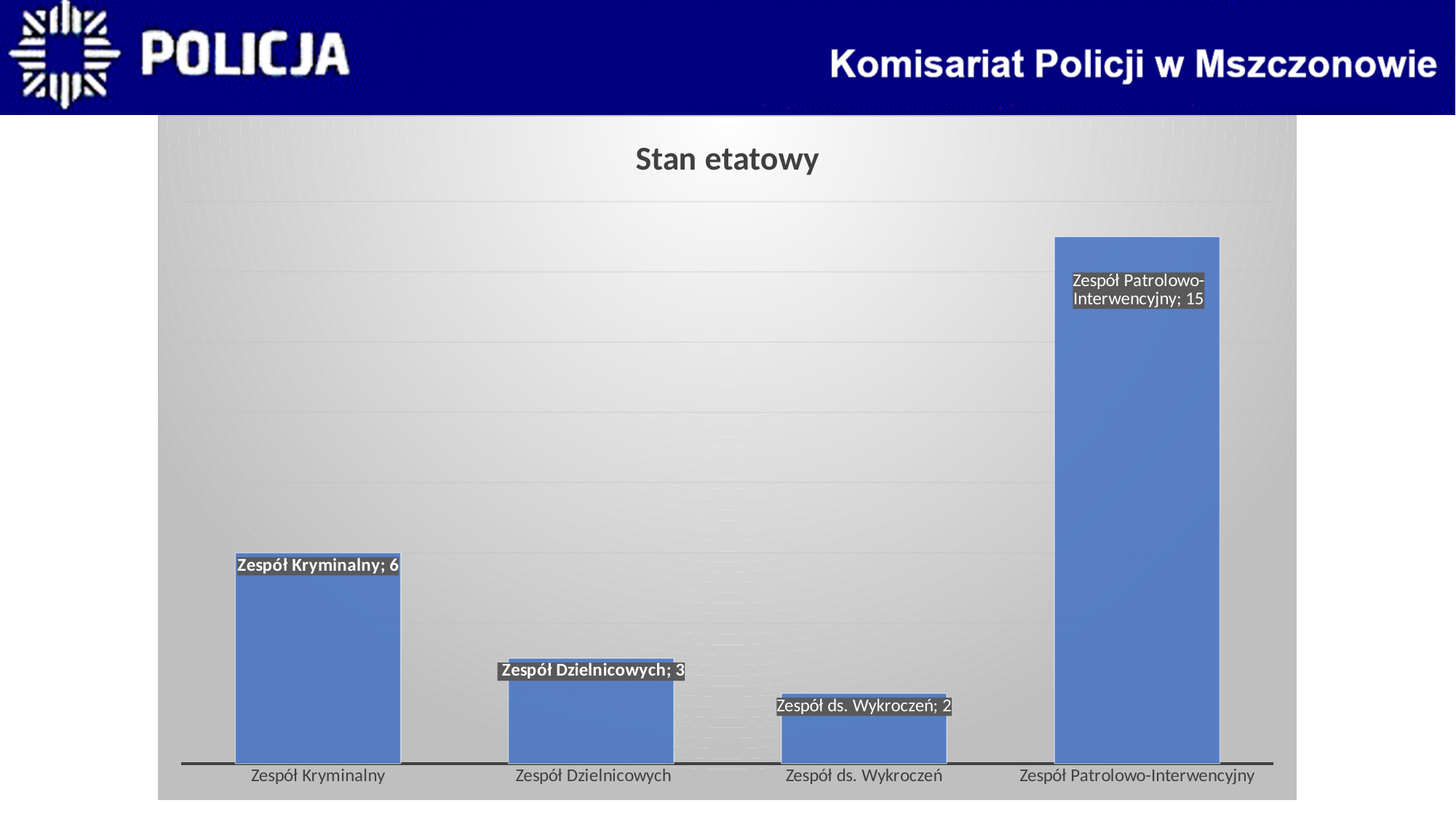
What is the difference between the values for Zespół Kryminalny and Zespół Dzielnicowych? 3 How many categories are shown in the chart? 4 What is the value for Zespół Kryminalny? 6 What is the difference between the values for Zespół Patrolowo-Interwencyjny and Zespół Kryminalny? 9 What is the title of the chart? Stan etatowy What kind of chart is shown on the slide? bar chart Which is larger, the value for Zespół Dzielnicowych or the value for Zespół ds. Wykroczeń? Zespół Dzielnicowych What is the value for Zespół Dzielnicowych? 3 What is the value for Zespół Patrolowo-Interwencyjny? 15 What is the value for Zespół ds. Wykroczeń? 2 Which category has the highest value? Zespół Patrolowo-Interwencyjny Which category has the lowest value? Zespół ds. Wykroczeń